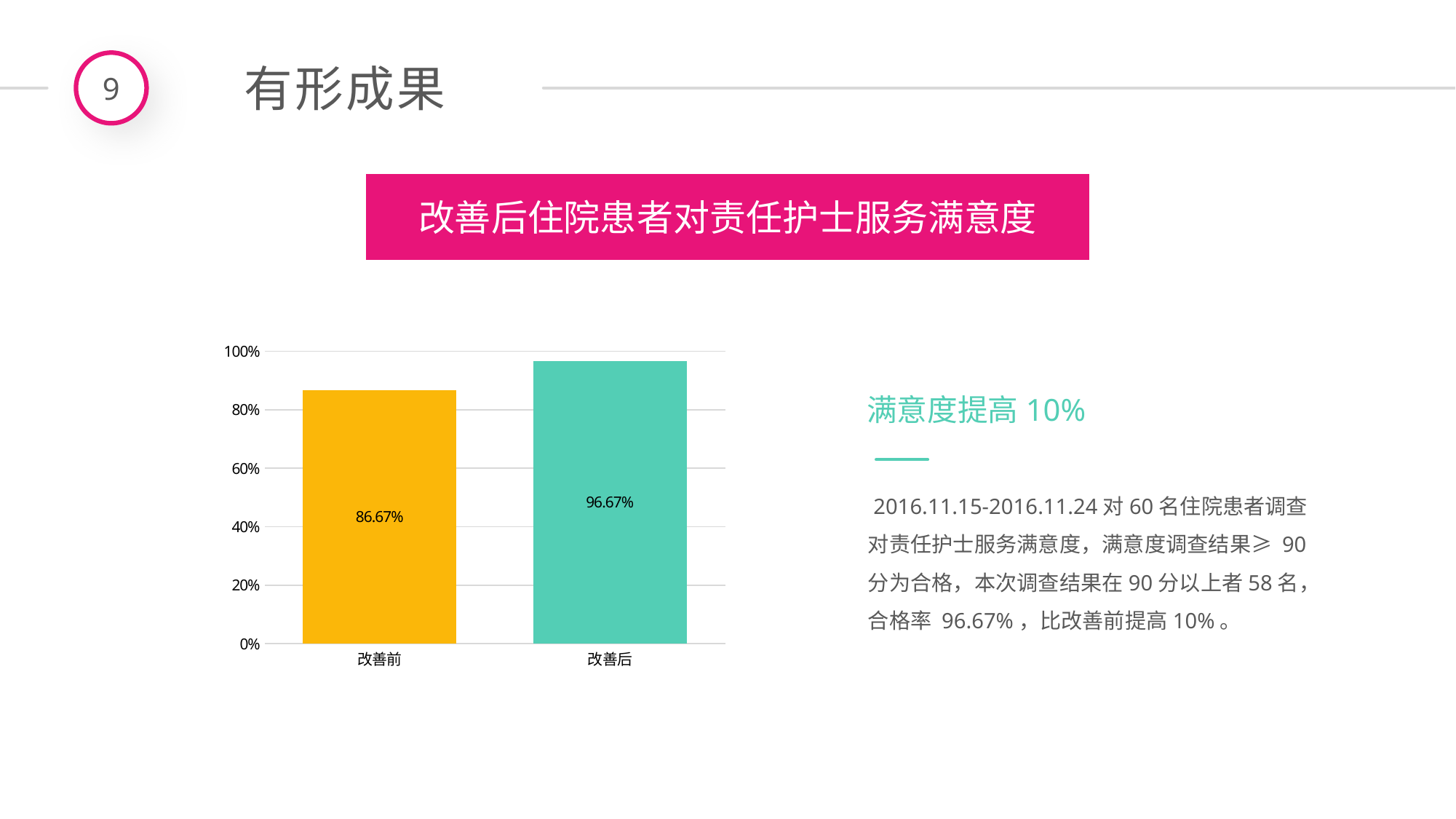
Is the value for 改善前 greater or less than 80%? greater Do the values rise or fall from 改善前 to 改善后? rise Which category has the highest value? 改善后 What is the value for 改善后? 96.67% How many categories are shown on the x axis? 2 Which category has the lowest value? 改善前 What is the value for 改善前? 86.67% Is the value for 改善后 greater or less than 100%? less What is the difference between the values for 改善后 and 改善前? 10% Which is larger, the value for 改善前 or the value for 改善后? 改善后 What kind of chart is shown on the slide? bar chart What colour is the bar for 改善后? teal (green)